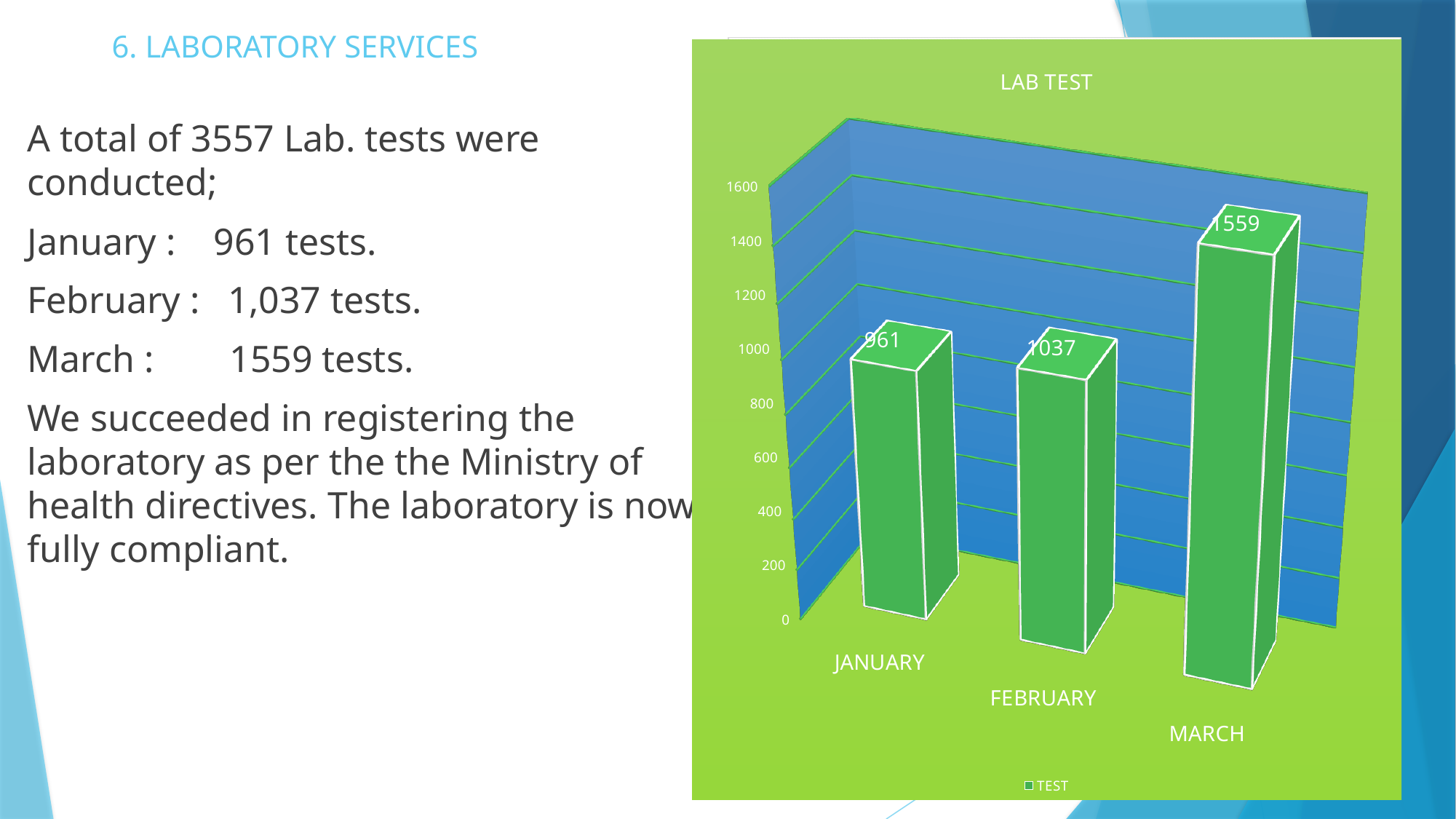
How many series does the legend of the LAB TEST chart list? 1 Which month has the lowest value in the LAB TEST chart? JANUARY What is the value for MARCH in the LAB TEST chart? 1559 Which is larger in the LAB TEST chart, the value for FEBRUARY or the value for MARCH? MARCH What is the value for FEBRUARY in the LAB TEST chart? 1037 Do the values in the LAB TEST chart rise or fall from JANUARY to MARCH? rise What is the value for JANUARY in the LAB TEST chart? 961 What kind of chart is the LAB TEST chart? bar chart How many categories are shown in the LAB TEST chart? 3 Which month has the highest value in the LAB TEST chart? MARCH What is the difference between the MARCH and JANUARY values in the LAB TEST chart? 598 What is the difference between the FEBRUARY and JANUARY values in the LAB TEST chart? 76